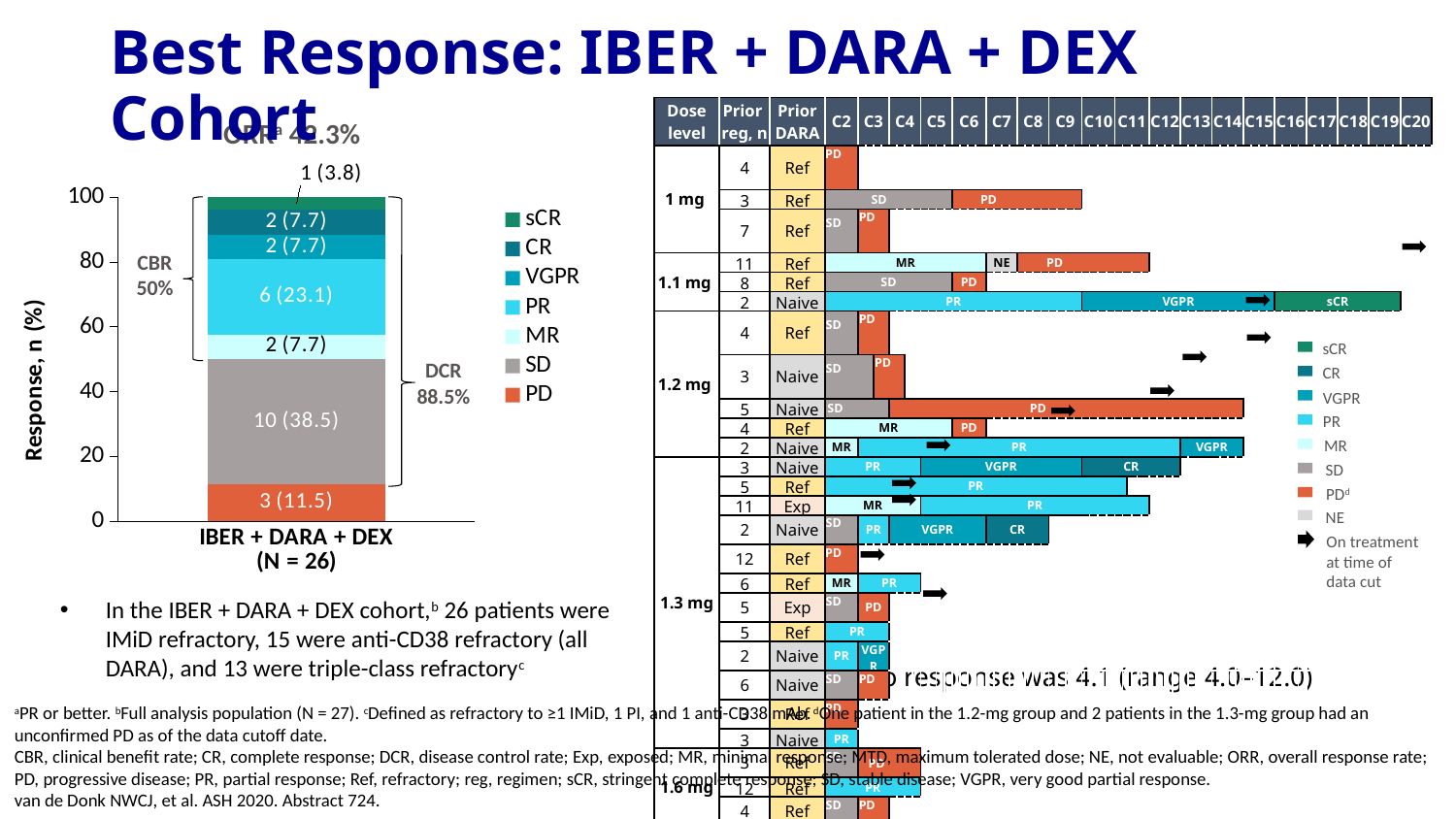
How many categories are shown on the x axis of the stacked bar chart? 1 How many series does the legend of the stacked bar chart list? 7 What kind of chart is the chart on the left of the slide? Stacked bar chart In the stacked bar chart, which response category has the largest segment? SD In the stacked bar chart, which segment is larger, PR or SD? SD What is the y-axis title of the stacked bar chart? Response, n (%) In the stacked bar chart, what is the value shown for the SD segment? 10 (38.5) In the stacked bar chart, what is the value shown for the PD segment? 3 (11.5) In the stacked bar chart, how many more patients are in the SD segment than in the PR segment? 4 In the stacked bar chart, what is the value shown for the PR segment of the IBER + DARA + DEX bar? 6 (23.1) What is the total number of patients (n) across all segments of the IBER + DARA + DEX stacked bar? 26 In the stacked bar chart, which response category has the smallest segment? sCR